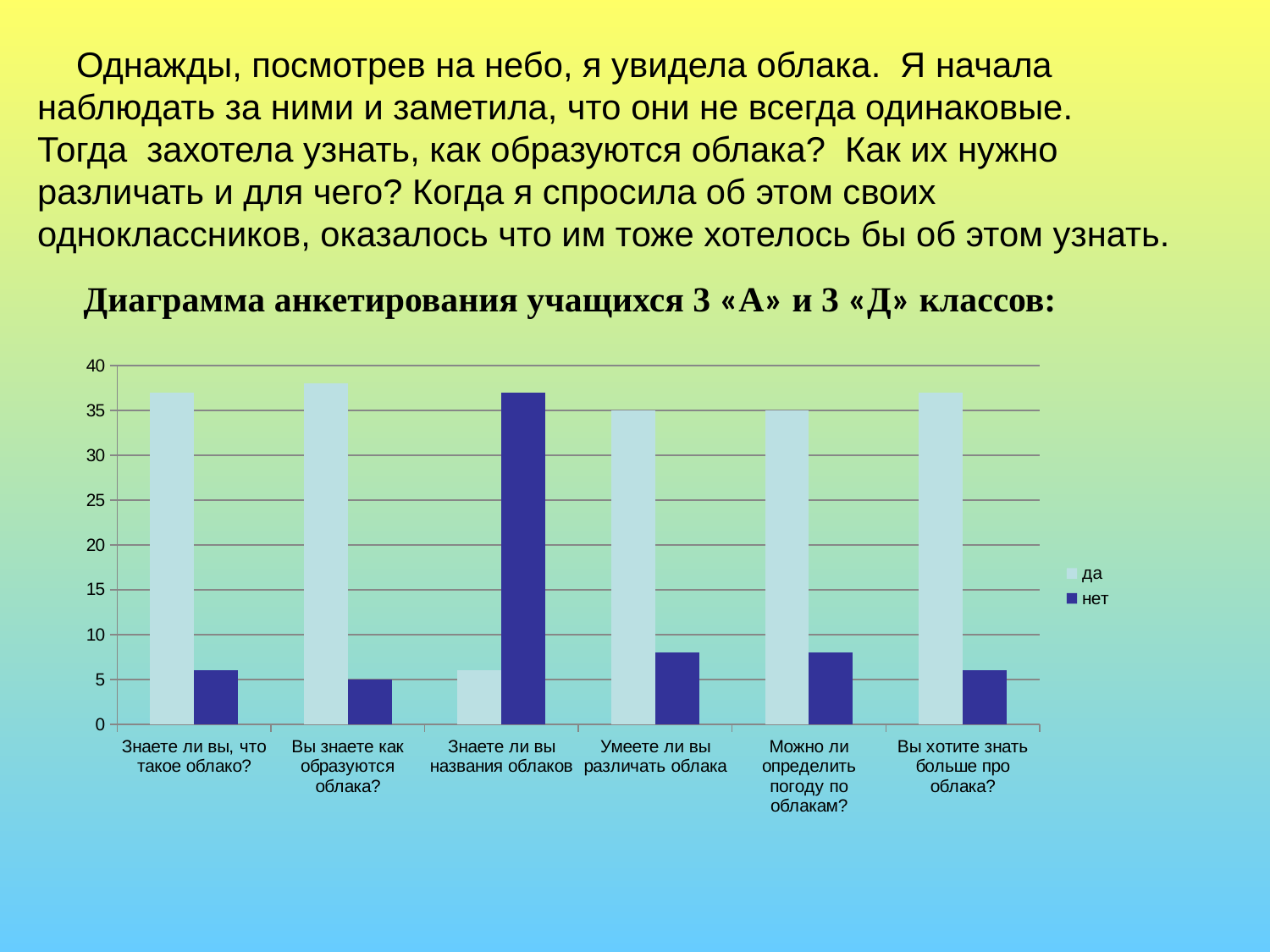
What kind of chart is shown on the slide? bar chart Is the "нет" value for "Знаете ли вы названия облаков" greater or less than 35? greater How many question categories are shown on the x axis? 6 Which category has the highest value for the "нет" series? Знаете ли вы названия облаков How many series does the legend list? 2 Which category has the lowest value for the "нет" series? Вы знаете как образуются облака? What are the two legend entries? да, нет Is the "да" value for "Знаете ли вы, что такое облако?" greater or less than 35? greater For "Знаете ли вы названия облаков", which is larger: the "да" value or the "нет" value? нет Which category has the lowest value for the "да" series? Знаете ли вы названия облаков Is the "нет" value for "Умеете ли вы различать облака" greater or less than 10? less For "Вы хотите знать больше про облака?", which is larger: the "да" value or the "нет" value? да